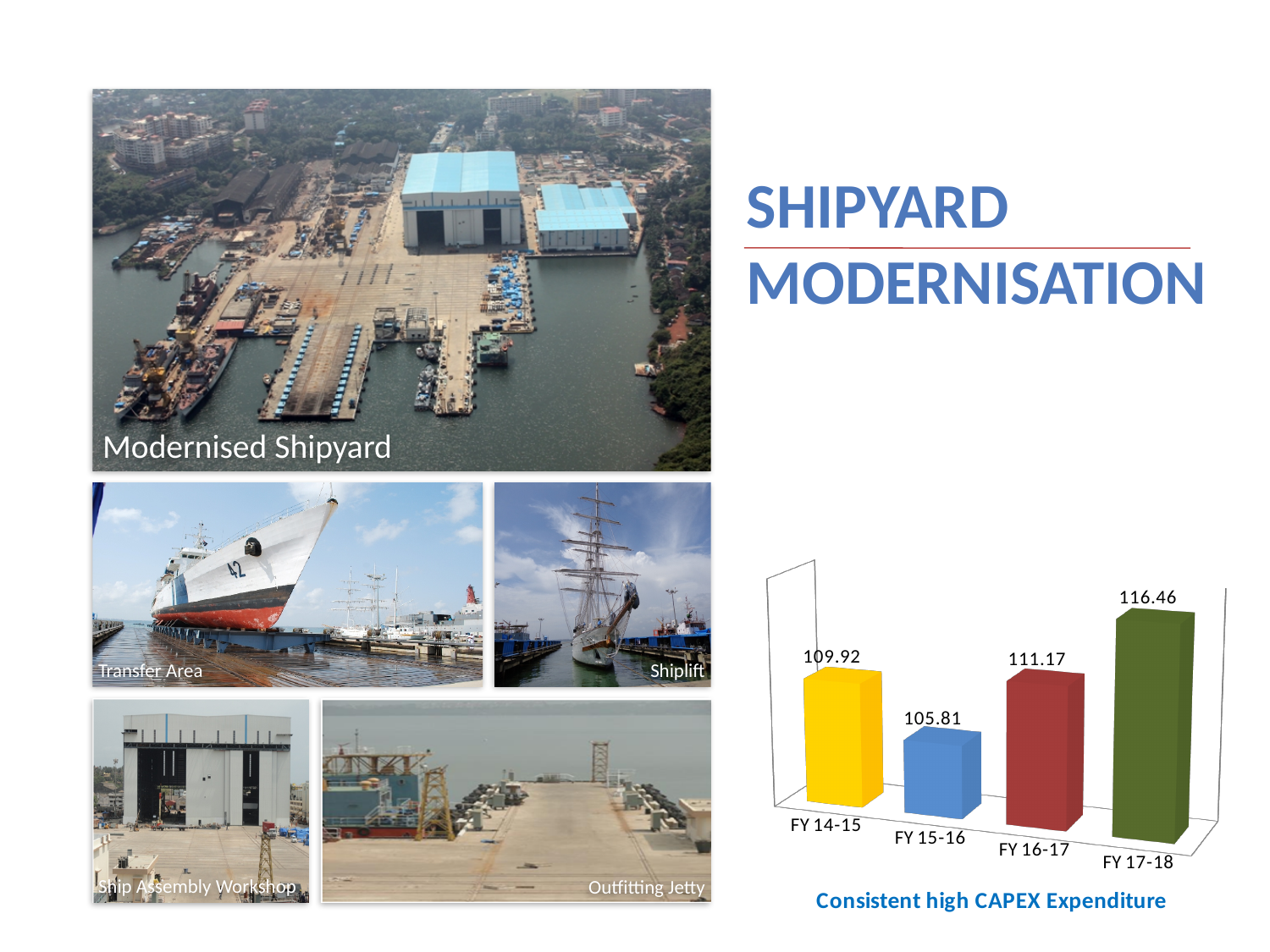
What caption appears below the CAPEX chart? Consistent high CAPEX Expenditure What is the value for FY 14-15 in the CAPEX chart? 109.92 What is the value for FY 15-16 in the CAPEX chart? 105.81 What is the value for FY 16-17 in the CAPEX chart? 111.17 Which is larger in the CAPEX chart, the value for FY 14-15 or FY 16-17? FY 16-17 Which fiscal year has the lowest value in the CAPEX chart? FY 15-16 Which fiscal year has the highest value in the CAPEX chart? FY 17-18 What kind of chart is used to show the CAPEX expenditure? Bar chart How many fiscal years are shown in the CAPEX chart? 4 What is the value for FY 17-18 in the CAPEX chart? 116.46 What is the difference between the values for FY 17-18 and FY 16-17 in the CAPEX chart? 5.29 What is the difference between the values for FY 14-15 and FY 15-16 in the CAPEX chart? 4.11